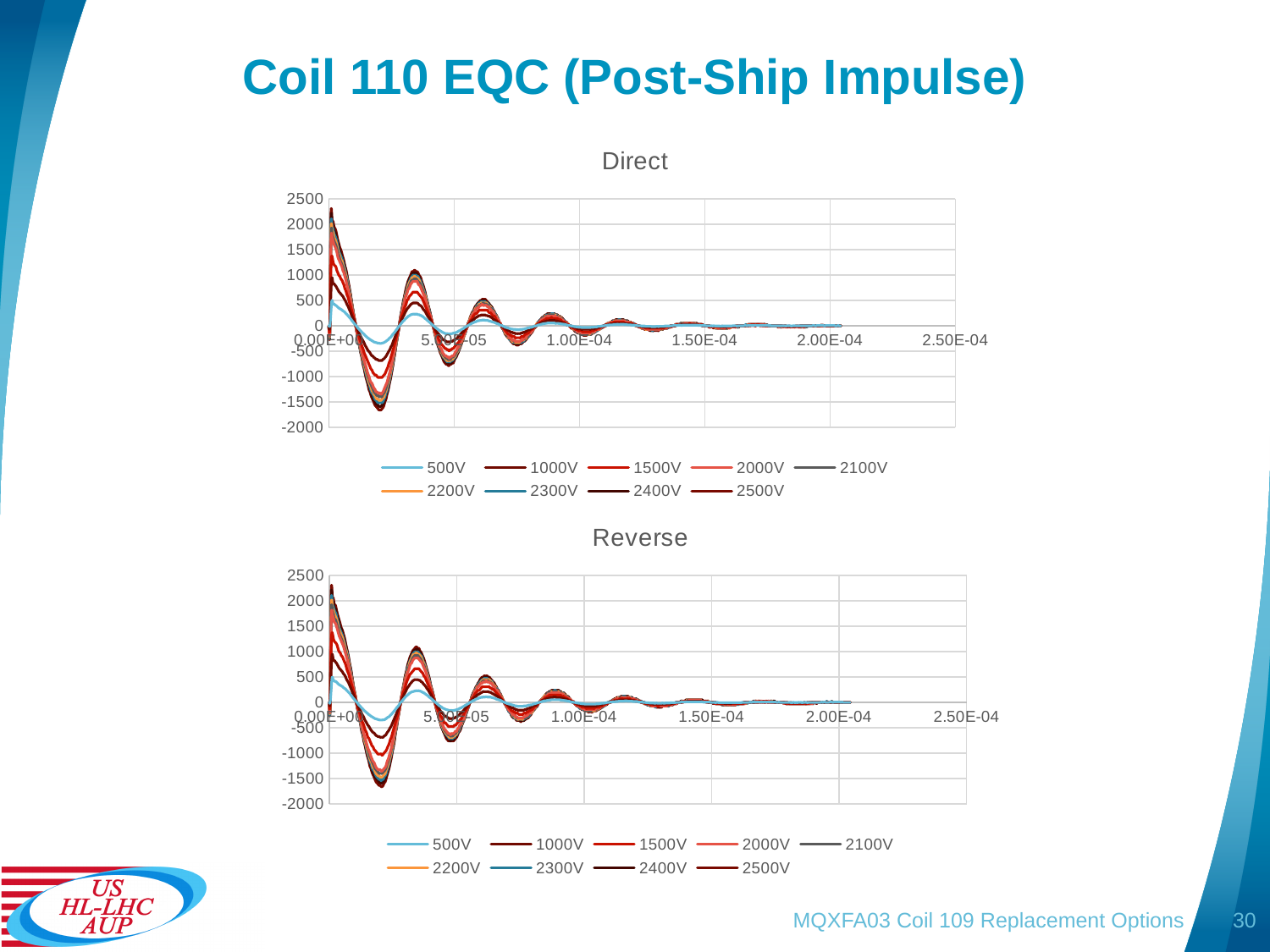
In the "Direct" chart, which series reaches a higher first peak, 500V or 2500V? 2500V In the "Reverse" chart, is the lowest trough of the 2500V series greater or less than -1000? less How many series does the legend of the "Reverse" chart list? 9 In the "Direct" chart, is the first peak of the 500V series greater or less than 1000? less What kind of chart is the "Reverse" chart? line chart What kind of chart is the "Direct" chart? line chart In the "Direct" chart, is the highest peak of the 2500V series greater or less than 2000? greater What is the highest value shown on the y axis of the "Reverse" chart? 2500 What is the title of the lower chart on the slide? Reverse What is the title of the upper chart on the slide? Direct How many series does the legend of the "Direct" chart list? 9 In the "Reverse" chart, does the amplitude of the oscillations increase or decrease along the x axis? decrease